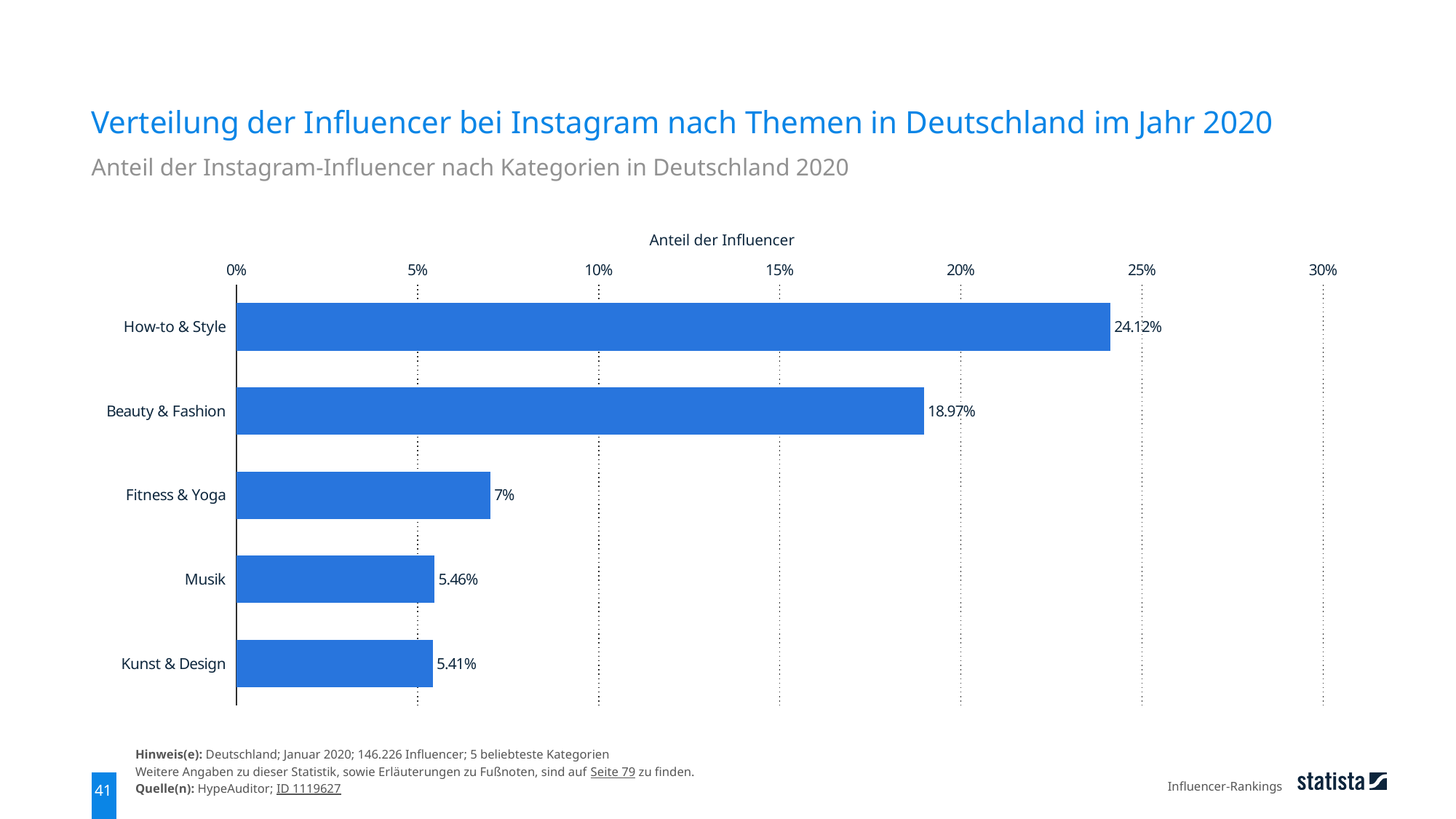
What is the share of influencers for Musik? 5.46% How many categories are shown in the chart? 5 Which has a larger share of influencers, Fitness & Yoga or Musik? Fitness & Yoga What is the share of influencers for Beauty & Fashion? 18.97% What is the difference in share between How-to & Style and Beauty & Fashion? 5.15% Which category has the lowest share of influencers? Kunst & Design What is the share of influencers for Kunst & Design? 5.41% Which category has the highest share of influencers? How-to & Style What is the label of the value axis of the chart? Anteil der Influencer What kind of chart is shown on the slide? Bar chart What is the share of influencers for Fitness & Yoga? 7% What is the share of influencers for How-to & Style? 24.12%